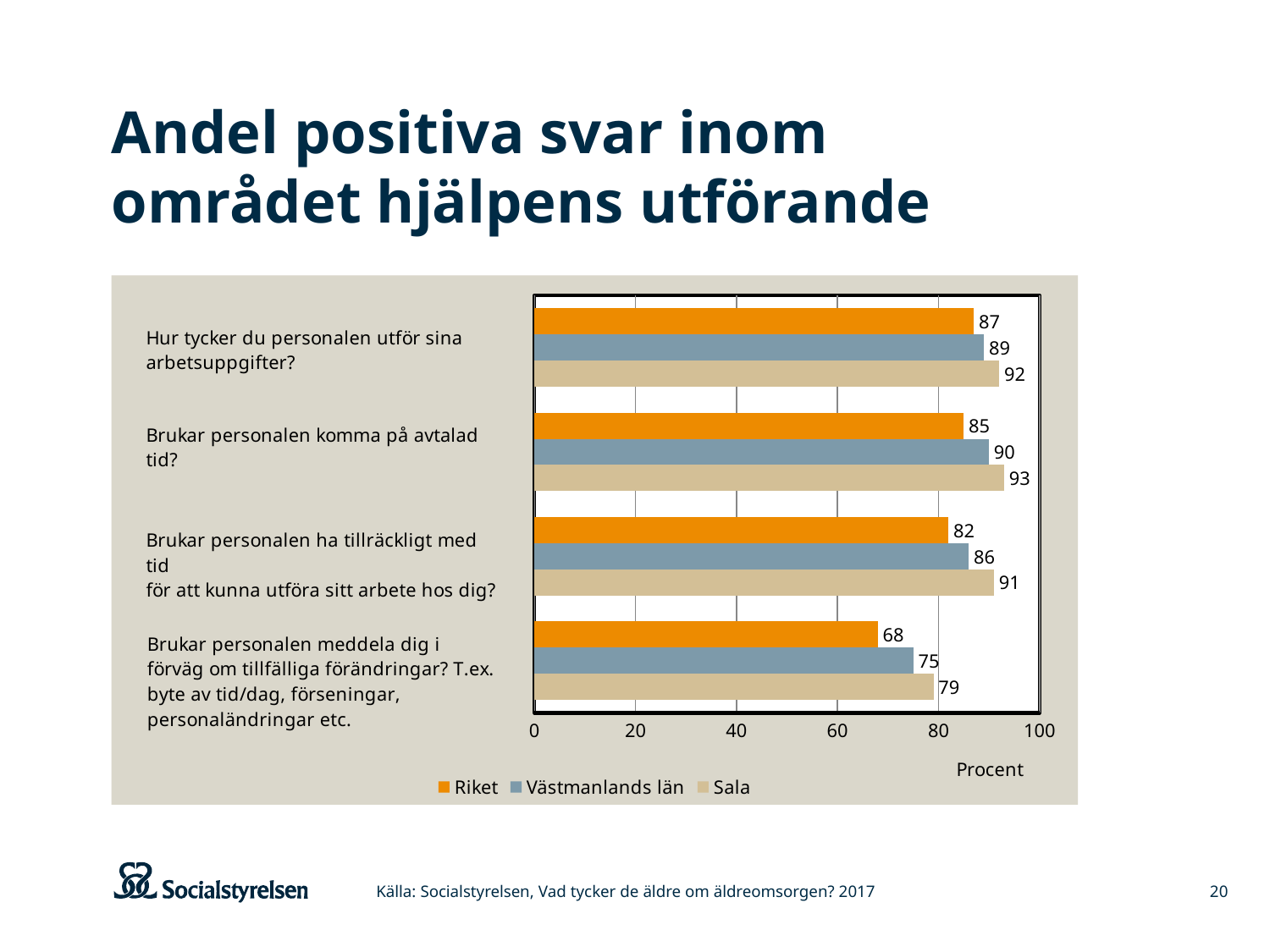
Which question has the lowest value for Riket? Brukar personalen meddela dig i förväg om tillfälliga förändringar? How many questions (categories) are shown on the chart? 4 What is the value for Västmanlands län for "Hur tycker du personalen utför sina arbetsuppgifter?"? 89 How many series does the legend list? 3 Which question has the highest value for Sala? Brukar personalen komma på avtalad tid? What is the value for Sala for "Brukar personalen komma på avtalad tid?"? 93 What is the value for Västmanlands län for "Brukar personalen ha tillräckligt med tid för att kunna utföra sitt arbete hos dig?"? 86 For "Hur tycker du personalen utför sina arbetsuppgifter?", which is larger: Riket or Sala? Sala What is the value for Riket for "Brukar personalen meddela dig i förväg om tillfälliga förändringar?"? 68 What is the difference between Sala and Riket for "Brukar personalen meddela dig i förväg om tillfälliga förändringar?"? 11 What kind of chart is shown on the slide? Bar chart What is the difference between Västmanlands län and Riket for "Brukar personalen komma på avtalad tid?"? 5